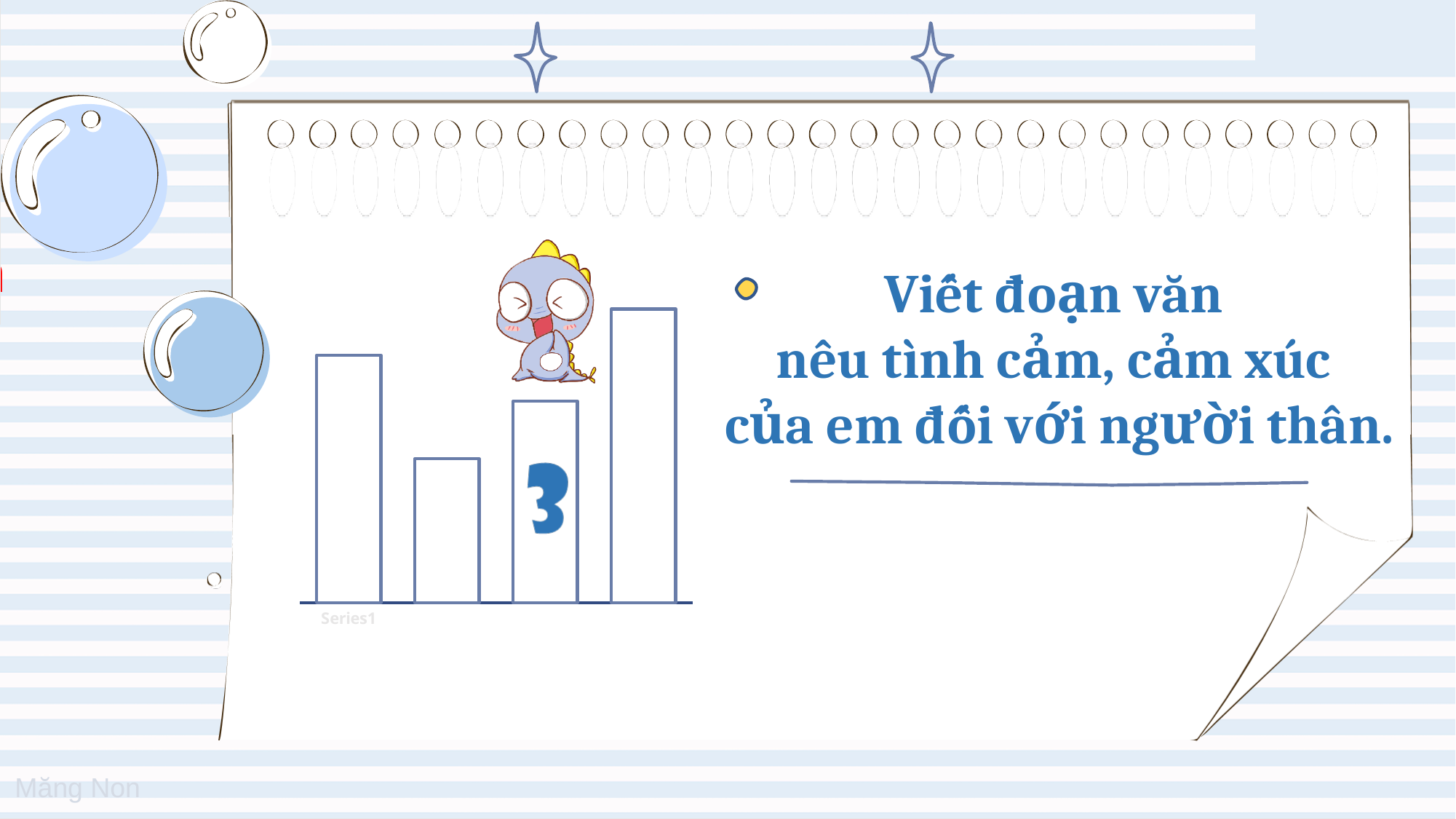
How many bars does the chart on the slide have? 4 What label is printed below the chart's horizontal axis? Series1 Do the bars rise steadily from left to right? no What kind of chart is shown on the slide? bar chart Which bar in the chart is the tallest? the fourth (rightmost) bar Which bar in the chart is the shortest? the second bar Does the chart display any numeric axis values or data labels? no Is the third bar or the fourth bar taller? the fourth bar Is the first bar or the second bar taller? the first bar Is the first bar or the third bar taller? the first bar